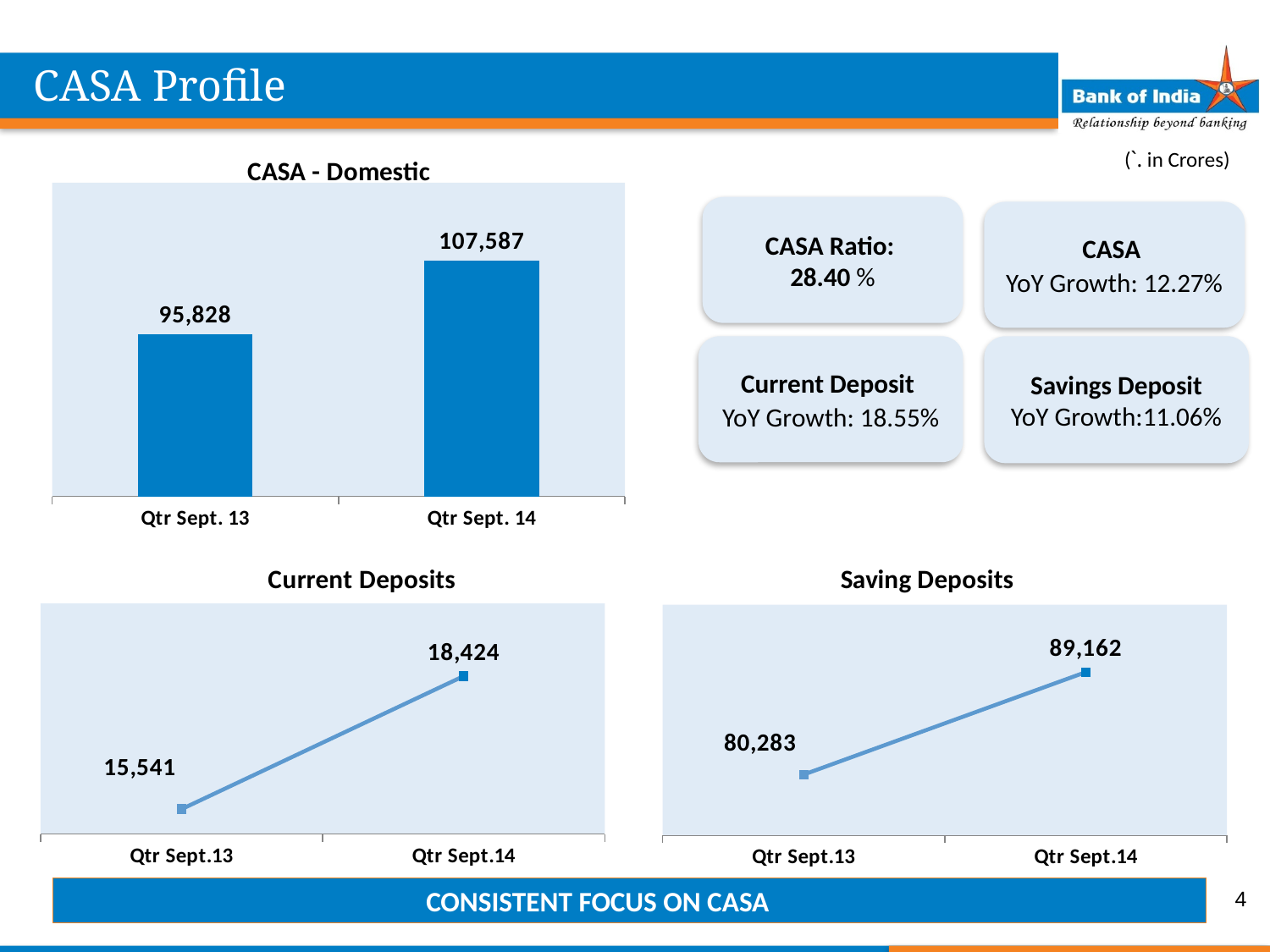
In the Saving Deposits chart, what is the difference between the Qtr Sept.14 and Qtr Sept.13 values? 8,879 In the Saving Deposits chart, what is the value for Qtr Sept.13? 80,283 In the CASA - Domestic chart, what is the value for Qtr Sept. 14? 107,587 In the CASA - Domestic chart, what is the value for Qtr Sept. 13? 95,828 In the Saving Deposits chart, do the values rise or fall from Qtr Sept.13 to Qtr Sept.14? Rise In the Saving Deposits chart, what is the value for Qtr Sept.14? 89,162 In the Current Deposits chart, what is the value for Qtr Sept.14? 18,424 What kind of chart is the Current Deposits chart? Line chart In the Current Deposits chart, by how much did the value increase from Qtr Sept.13 to Qtr Sept.14? 2,883 What kind of chart is the CASA - Domestic chart? Bar chart In the Current Deposits chart, what is the value for Qtr Sept.13? 15,541 In the CASA - Domestic chart, what is the difference between the Qtr Sept. 14 and Qtr Sept. 13 values? 11,759